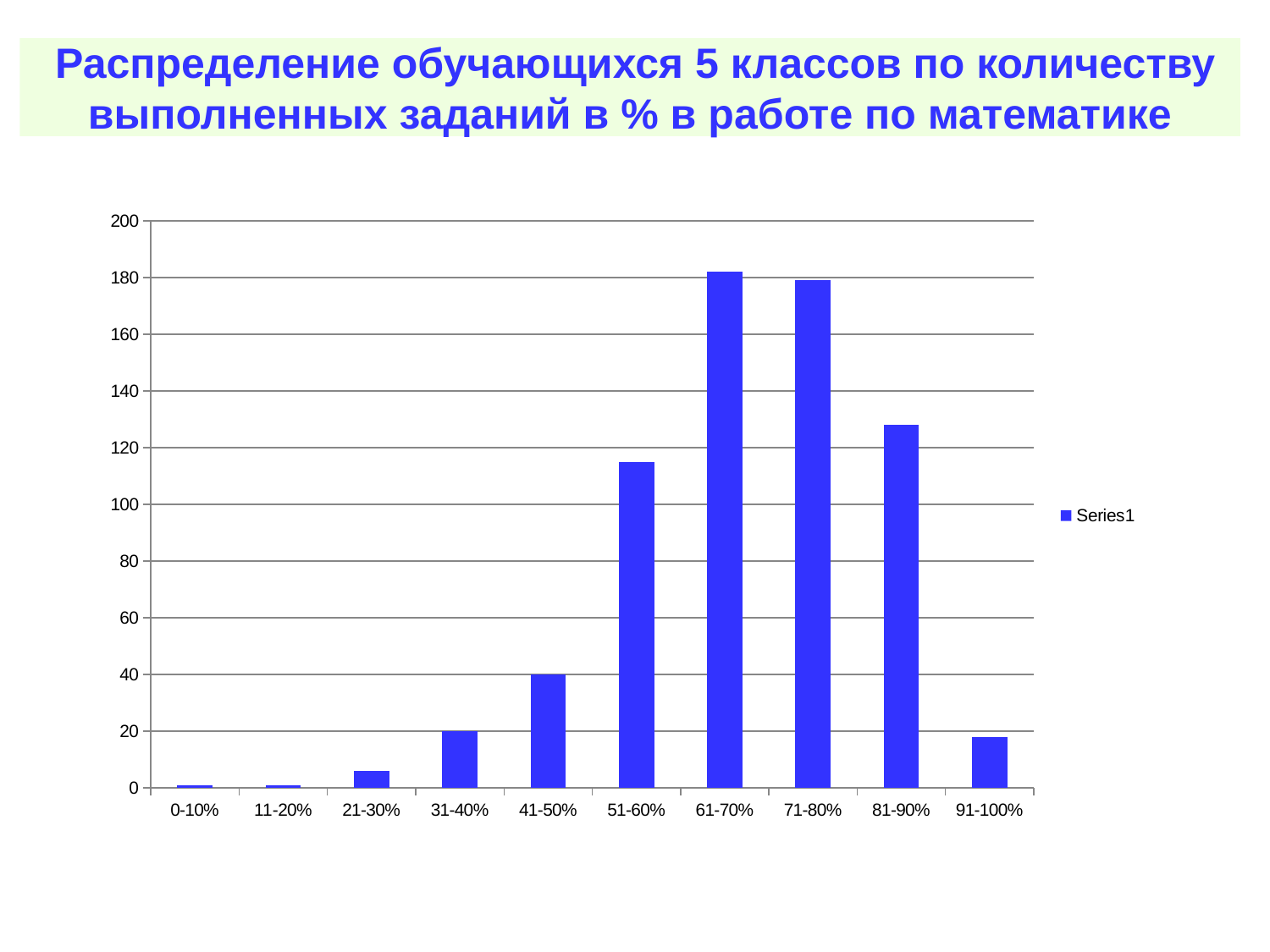
What kind of chart is shown on the slide? bar chart How many categories are shown on the x axis of the chart? 10 What is the value for the 31-40% category? 20 Do the values rise or fall from the 0-10% category to the 61-70% category? rise Which is larger, the value for 51-60% or the value for 81-90%? 81-90% Is the value for 51-60% greater or less than 100? greater Is the value for 91-100% greater or less than 40? less How many series does the legend list? 1 What is the difference between the values for 41-50% and 31-40%? 20 What is the value for the 41-50% category? 40 Is the value for 61-70% greater or less than 160? greater